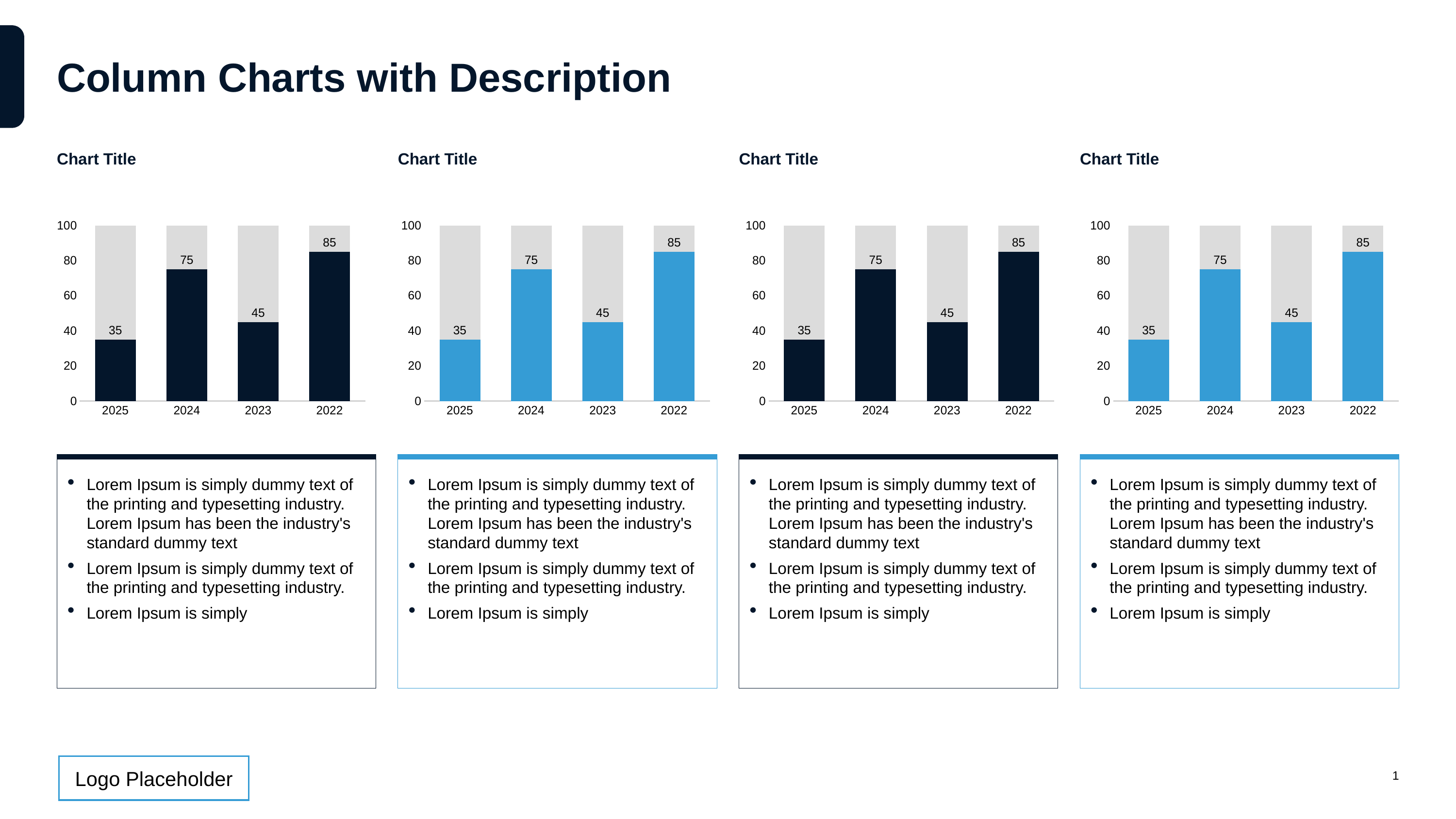
What colour are the labelled bars in the second chart from the left? blue In the second chart from the left, what is the value for 2024? 75 How many charts are shown on the slide? 4 In the third chart from the left, what is the value for 2023? 45 In the rightmost chart, which year has the lowest labelled value? 2025 In the rightmost chart, what is the value for 2022? 85 What type of chart is the rightmost chart? bar chart In the leftmost chart, which year has the highest labelled value? 2022 How many years are shown on the x axis of the leftmost chart? 4 In the second chart from the left, what is the difference between the values for 2022 and 2025? 50 In the third chart from the left, which is larger, the value for 2024 or the value for 2023? 2024 In the leftmost chart, what is the value for 2025? 35